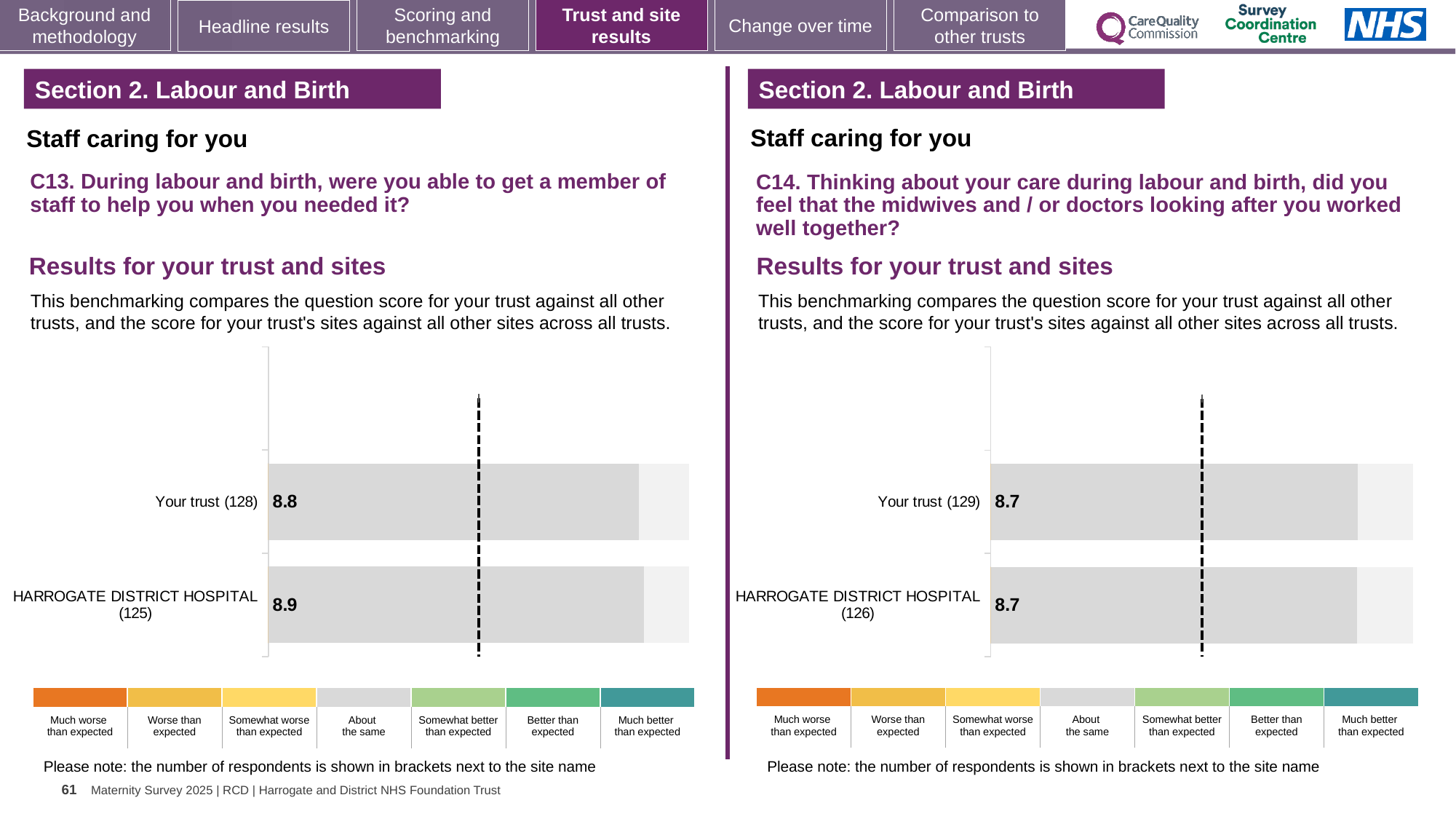
In the C14 chart on the right, is the Your trust score larger than, smaller than, or equal to the Harrogate District Hospital score? equal In the C14 chart on the right, what is the score for Harrogate District Hospital? 8.7 How many categories does the colour legend below the C13 chart on the left list? 7 In the C14 chart on the right, what is the score for Your trust? 8.7 In the C13 chart on the left, what is the score for Harrogate District Hospital? 8.9 In the C13 chart on the left, which bar has the higher score? Harrogate District Hospital What type of chart is used in the C14 chart on the right? bar chart In the C13 chart on the left, what is the score for Your trust? 8.8 How many bars are plotted in the C13 chart on the left? 2 In the C14 chart on the right, how many respondents are shown in brackets for Harrogate District Hospital? 126 In the C13 chart on the left, how many respondents are shown in brackets for Your trust? 128 In the C13 chart on the left, what is the difference between the Harrogate District Hospital score and the Your trust score? 0.1